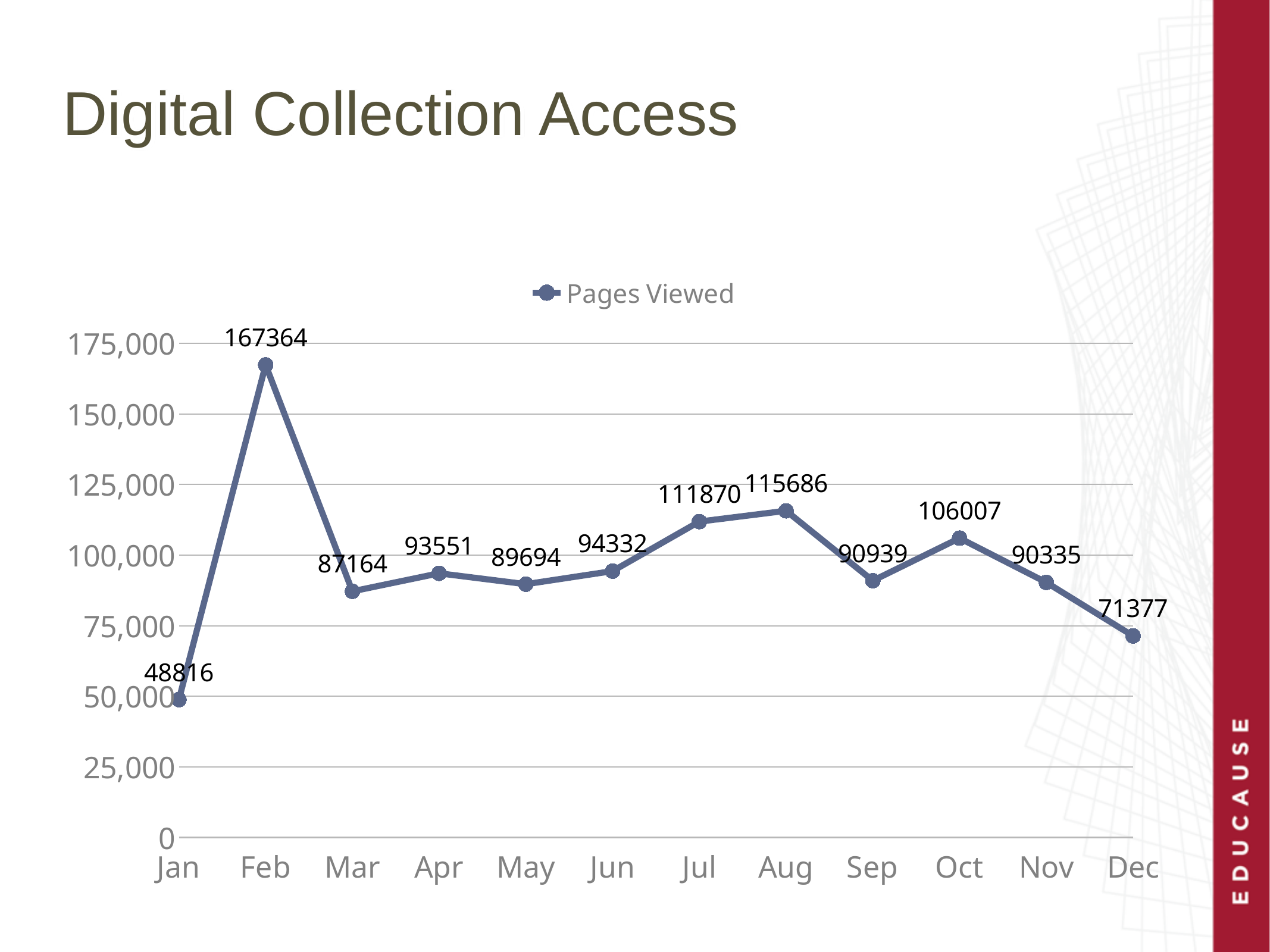
What is the Pages Viewed value for Dec? 71377 What series does the legend list? Pages Viewed What is the Pages Viewed value for Oct? 106007 What kind of chart is shown on the slide? Line chart What is the difference in pages viewed between Aug and Jul? 3816 Is the value for Sep greater or less than 100,000? less Which month had more pages viewed, Apr or May? Apr Which month has the highest number of pages viewed? Feb How many pages were viewed in Feb? 167364 Which month has the lowest number of pages viewed? Jan What is the difference in pages viewed between Feb and Jan? 118548 How many months are plotted on the x axis? 12